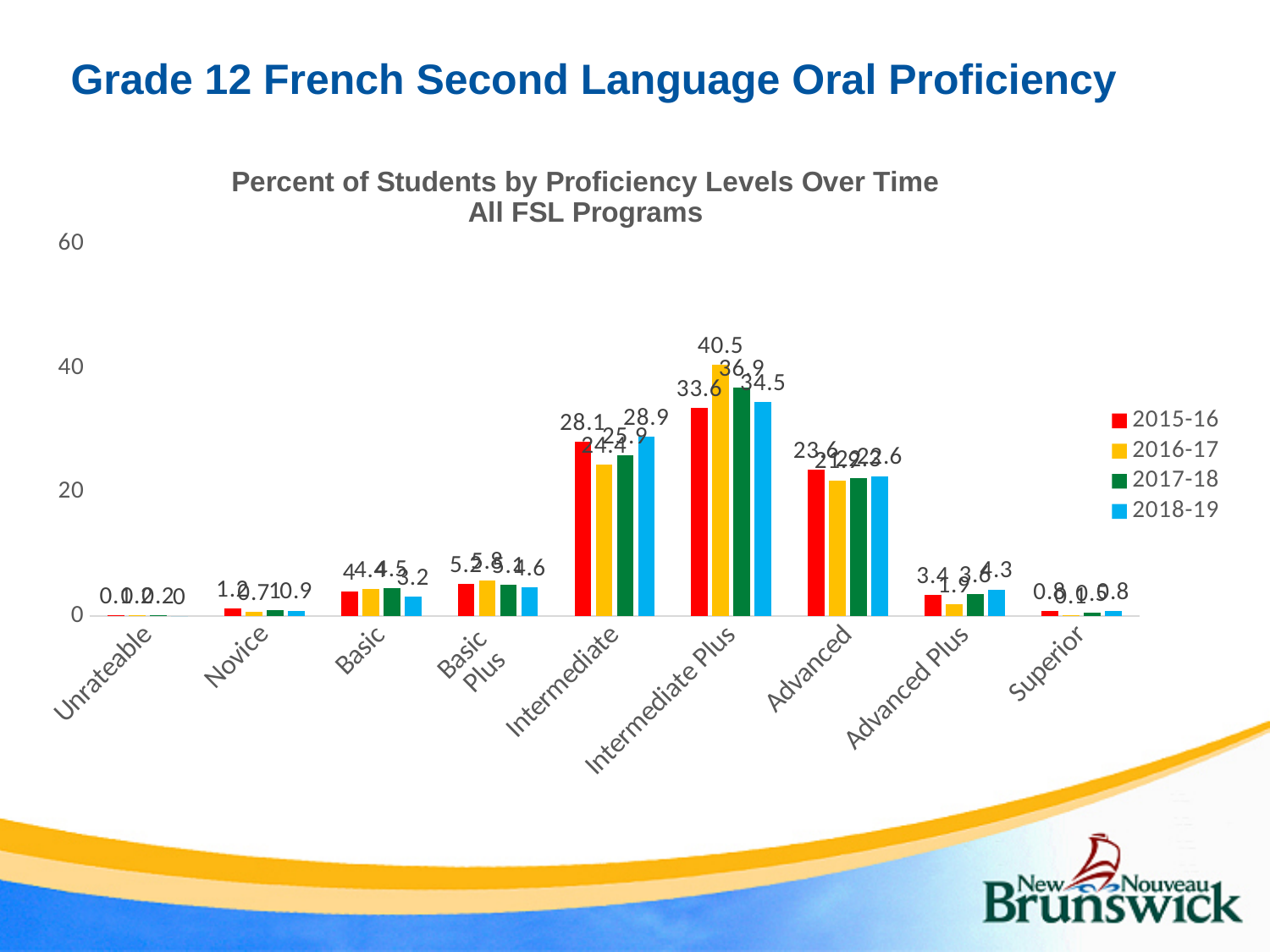
What kind of chart is shown on the slide? bar chart Is the value for Advanced in 2015-16 greater or less than 20? greater For Intermediate, which is larger: the 2015-16 value or the 2018-19 value? 2018-19 Which proficiency level has the highest value for 2016-17? Intermediate Plus What is the value for Basic in 2018-19? 3.2 What is the value for Intermediate Plus in 2016-17? 40.5 Which colour represents the 2017-18 series in the legend? green What is the value for Advanced Plus in 2016-17? 1.9 What is the value for Intermediate in 2018-19? 28.9 How many series does the legend list? 4 How many proficiency level categories are shown on the x axis? 9 What is the difference between the 2016-17 and 2015-16 values for Intermediate Plus? 6.9